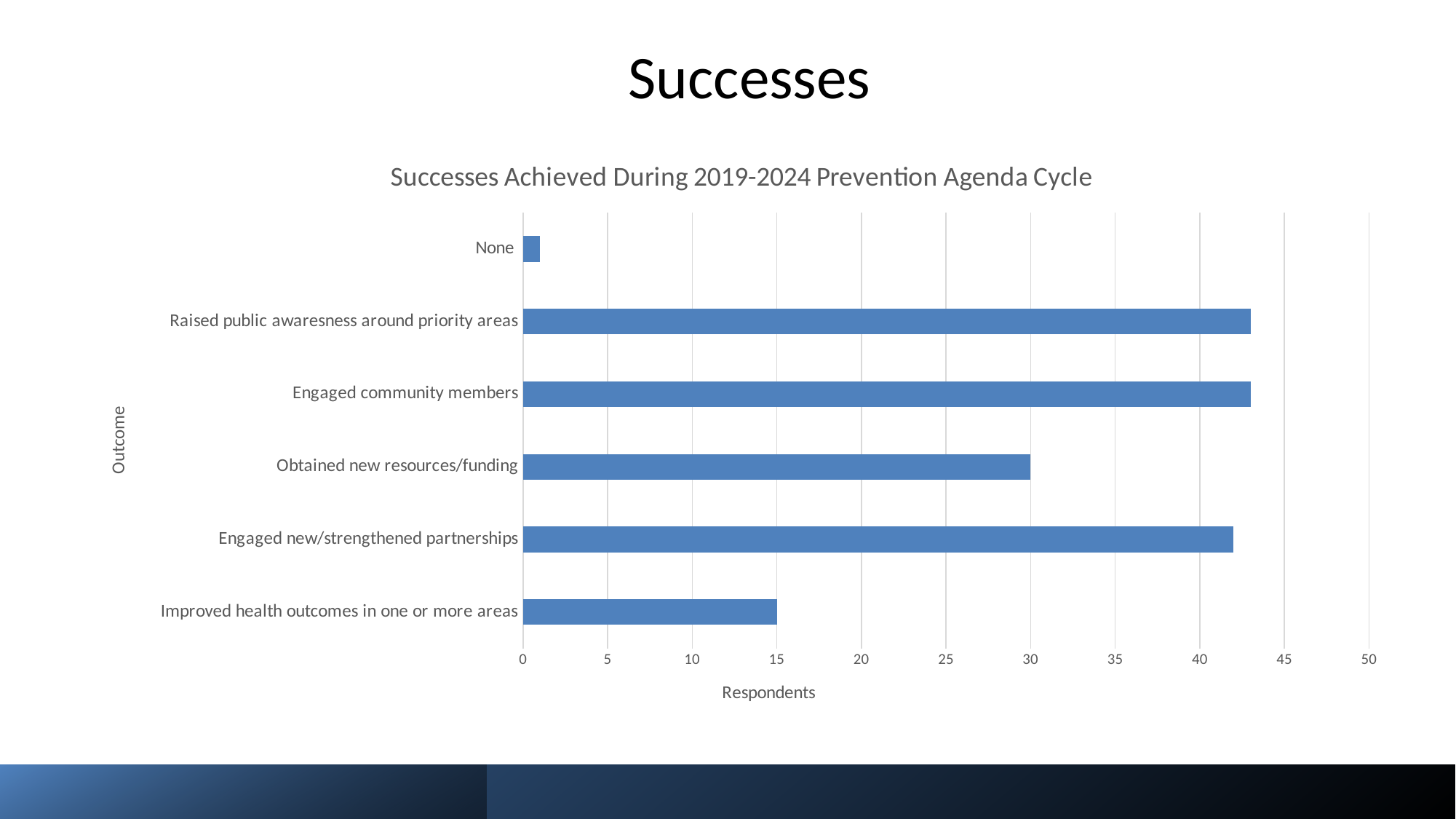
How many respondents reported 'Obtained new resources/funding'? 30 Is the value for 'Raised public awaresness around priority areas' greater or less than 40? greater What type of chart is shown on the slide? Bar chart Which has more respondents: 'Obtained new resources/funding' or 'Improved health outcomes in one or more areas'? Obtained new resources/funding What is the difference in respondents between 'Obtained new resources/funding' and 'Improved health outcomes in one or more areas'? 15 Is the value for 'None' greater or less than 5? less Is the value for 'Engaged new/strengthened partnerships' greater or less than 40? greater What is the title of the chart? Successes Achieved During 2019-2024 Prevention Agenda Cycle Which outcome has the lowest number of respondents? None How many outcome categories are shown in the chart? 6 How many respondents reported 'Improved health outcomes in one or more areas'? 15 What is the label of the horizontal axis? Respondents